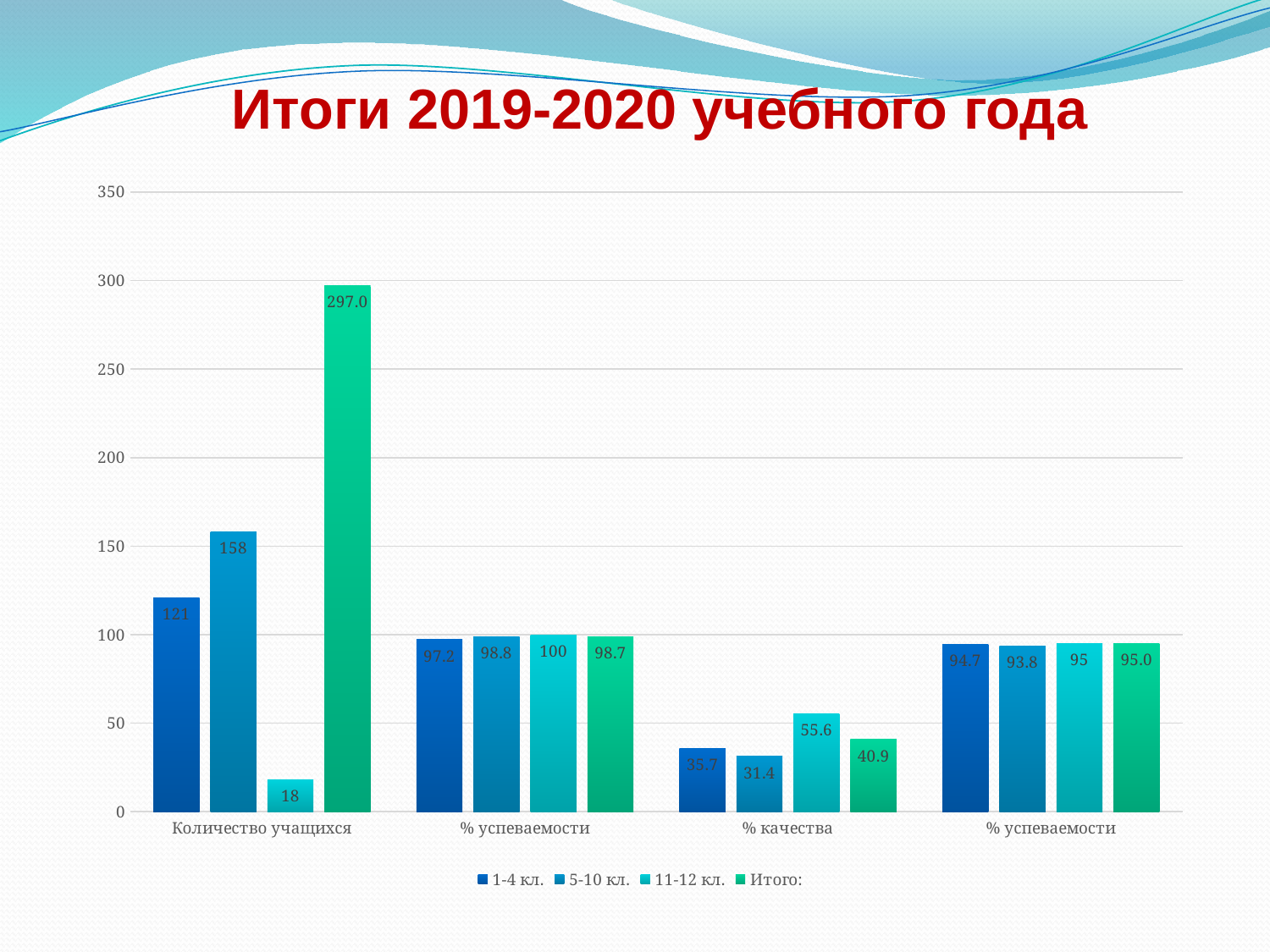
How many categories are shown along the x axis? 4 What is the difference between the '5-10 кл.' and '1-4 кл.' values in the 'Количество учащихся' category? 37 What is the title of the slide? Итоги 2019-2020 учебного года Which series has the lowest value in the 'Количество учащихся' category? 11-12 кл. In the '% качества' category, which is larger: the value for '1-4 кл.' or the value for 'Итого:'? Итого: What is the value for '5-10 кл.' in the '% качества' category? 31.4 Which series has the highest value in the '% качества' category? 11-12 кл. Is the value for 'Итого:' in the 'Количество учащихся' category greater or less than 250? greater What is the value for '11-12 кл.' in the 'Количество учащихся' category? 18 What is the value for 'Итого:' in the 'Количество учащихся' category? 297.0 How many series does the legend list? 4 What type of chart is shown on the slide? bar chart